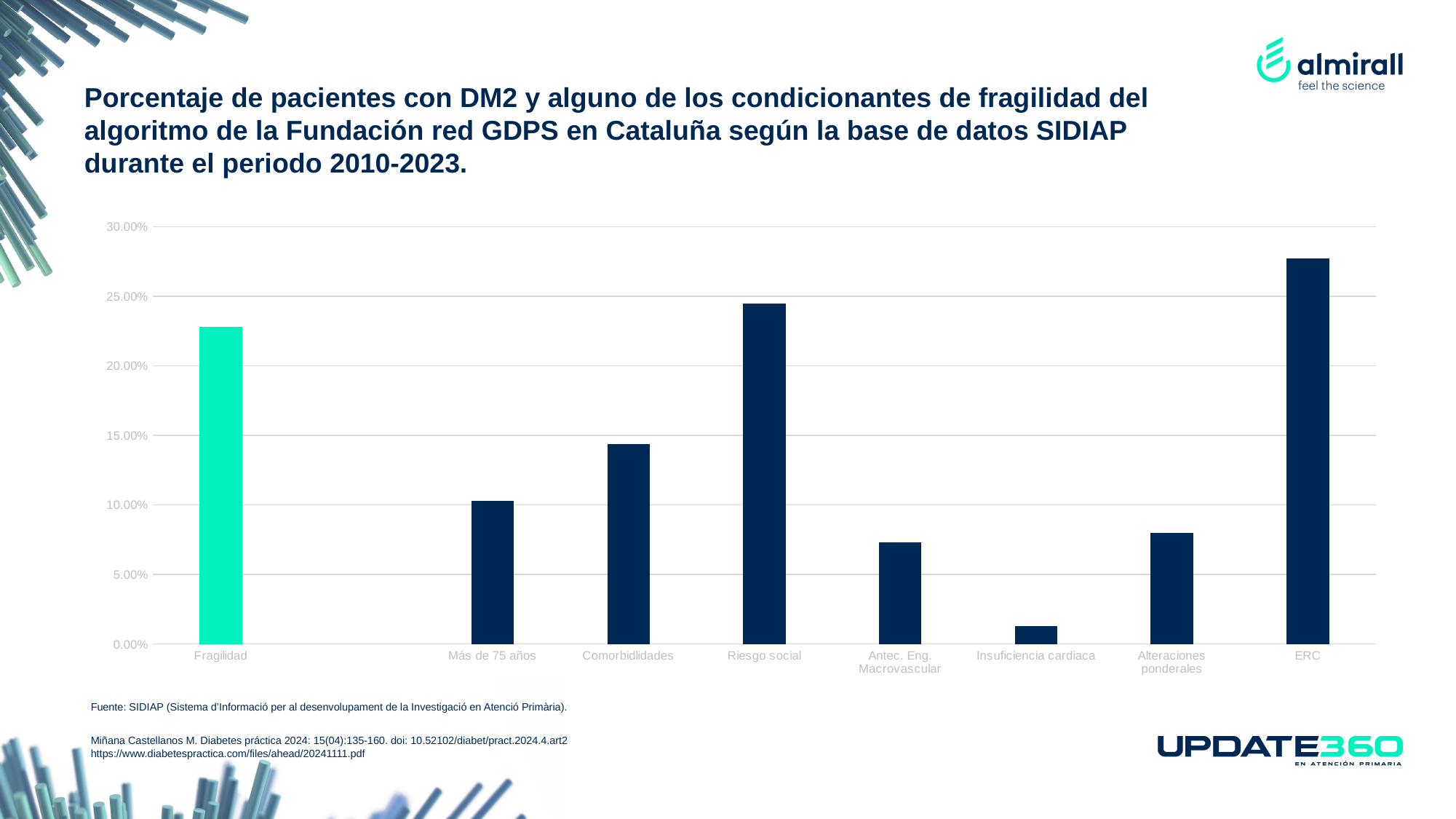
Which category has the lowest value? Insuficiencia cardiaca What kind of chart is shown on the slide? Bar chart Is the value for Comorbidlidades greater or less than 15.00%? less Is the value for Fragilidad greater or less than 20.00%? greater Which is larger, the value for Comorbidlidades or the value for Más de 75 años? Comorbidlidades Is the value for Antec. Eng. Macrovascular greater or less than 10.00%? less How many bars are plotted in the chart? 8 Which bar is shown in a different colour (green) from the rest? Fragilidad Which category has the highest value? ERC Which is larger, the value for Riesgo social or the value for Fragilidad? Riesgo social